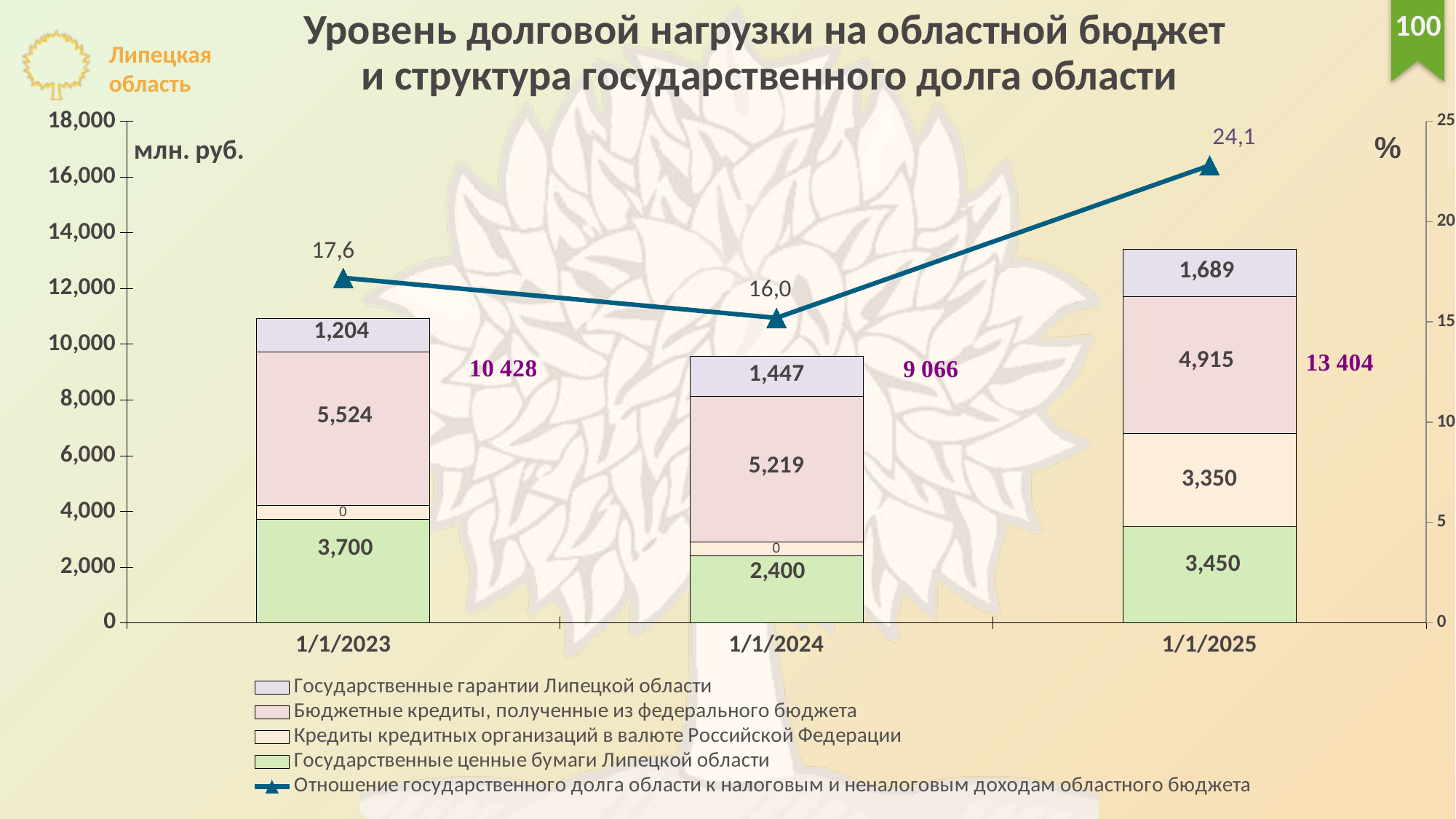
What is the value of Бюджетные кредиты, полученные из федерального бюджета on 1/1/2025? 4,915 Which is larger: Государственные ценные бумаги Липецкой области on 1/1/2025 or Кредиты кредитных организаций в валюте Российской Федерации on 1/1/2025? Государственные ценные бумаги Липецкой области What kind of chart is shown on the slide? Stacked bar chart with a line What is the value of Государственные ценные бумаги Липецкой области on 1/1/2023? 3,700 What is the total of the stacked bar for 1/1/2024? 9 066 What is the difference between Бюджетные кредиты, полученные из федерального бюджета on 1/1/2023 and on 1/1/2024? 305 What is the value of the line series Отношение государственного долга области к налоговым и неналоговым доходам областного бюджета on 1/1/2025? 24,1 On which date is the line series Отношение государственного долга области к налоговым и неналоговым доходам областного бюджета lowest? 1/1/2024 What is the value of Государственные гарантии Липецкой области on 1/1/2024? 1,447 How many series does the legend list? 5 On which date is the total stacked bar highest? 1/1/2025 How many dates are shown on the x axis? 3